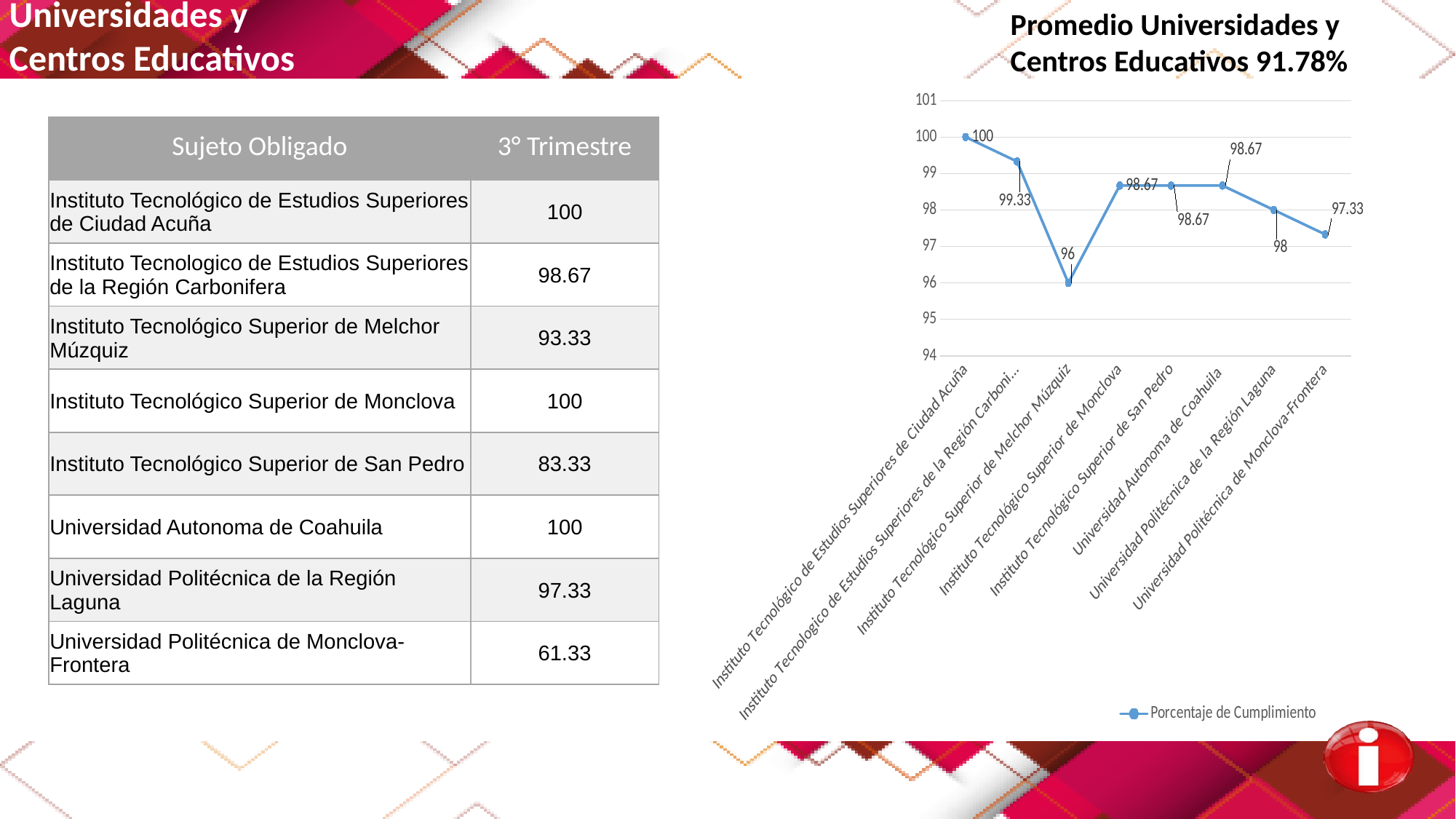
What type of chart is shown on the right side of the slide? Line chart How many institutions are plotted along the x axis of the line chart? 8 How many series does the legend of the line chart list? 1 What is the name of the series shown in the legend of the line chart? Porcentaje de Cumplimiento In the line chart, what value is plotted for Instituto Tecnológico Superior de Melchor Múzquiz? 96 In the line chart, what is the Porcentaje de Cumplimiento value for Instituto Tecnológico de Estudios Superiores de Ciudad Acuña? 100 In the line chart, which is larger: the value for Universidad Politécnica de la Región Laguna or the value for Universidad Politécnica de Monclova-Frontera? Universidad Politécnica de la Región Laguna In the line chart, what is the difference between the values for Ciudad Acuña (100) and Melchor Múzquiz (96)? 4 In the line chart, what value is plotted for Universidad Politécnica de la Región Laguna? 98 In the line chart, what value is plotted for Universidad Politécnica de Monclova-Frontera? 97.33 In the line chart, which institution has the highest plotted value? Instituto Tecnológico de Estudios Superiores de Ciudad Acuña In the line chart, which institution has the lowest plotted value? Instituto Tecnológico Superior de Melchor Múzquiz